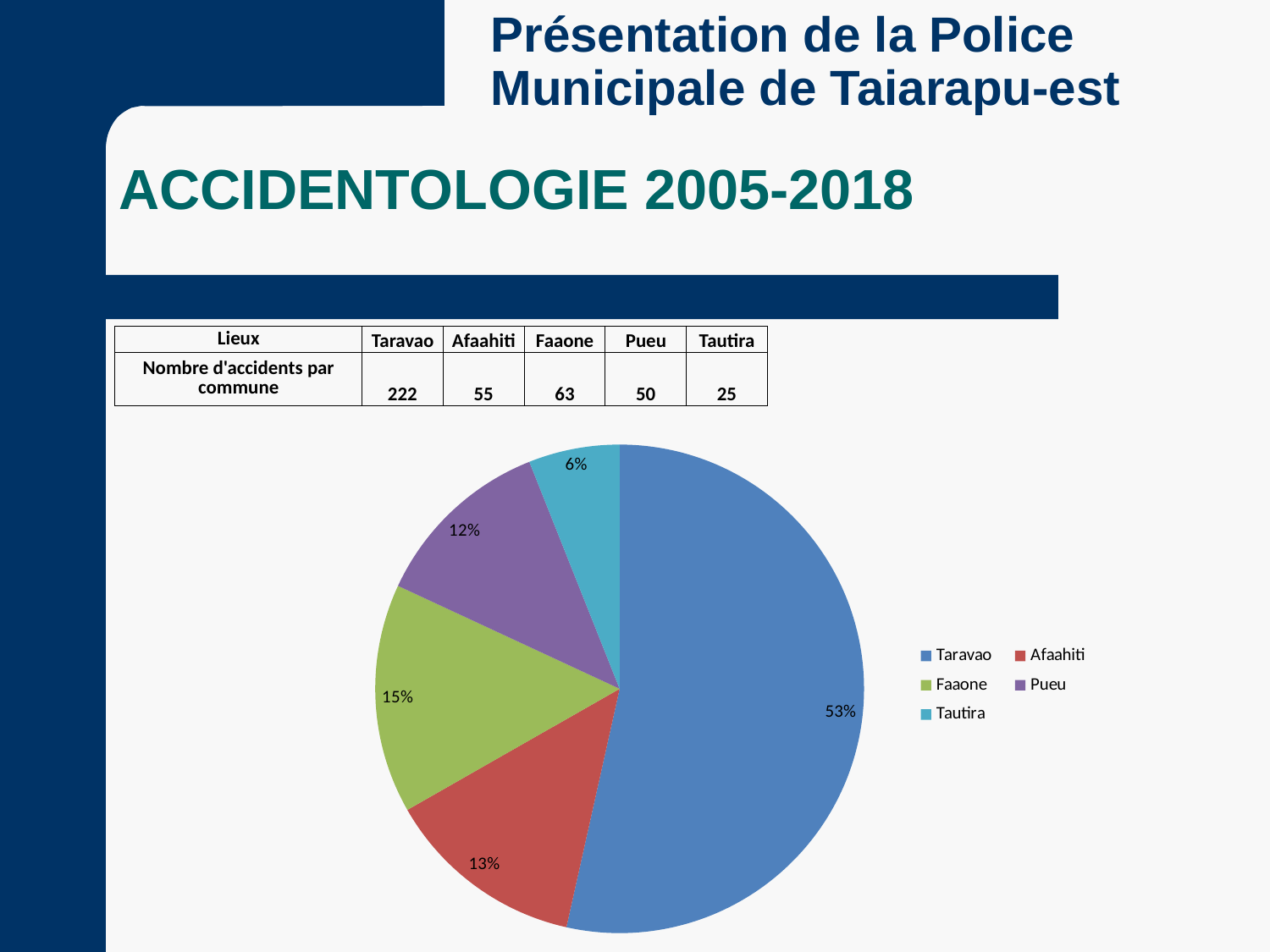
What share of the pie does Pueu represent? 12% What share of the pie does Tautira represent? 6% Which slice is larger, Faaone or Pueu? Faaone What share of the pie does Afaahiti represent? 13% How many slices does the pie chart have? 5 How many entries does the legend of the pie chart list? 5 Which commune has the smallest slice of the pie? Tautira What kind of chart is shown on the slide? pie chart What is the difference in percentage points between the Taravao slice and the Afaahiti slice? 40 Which commune has the largest slice of the pie? Taravao